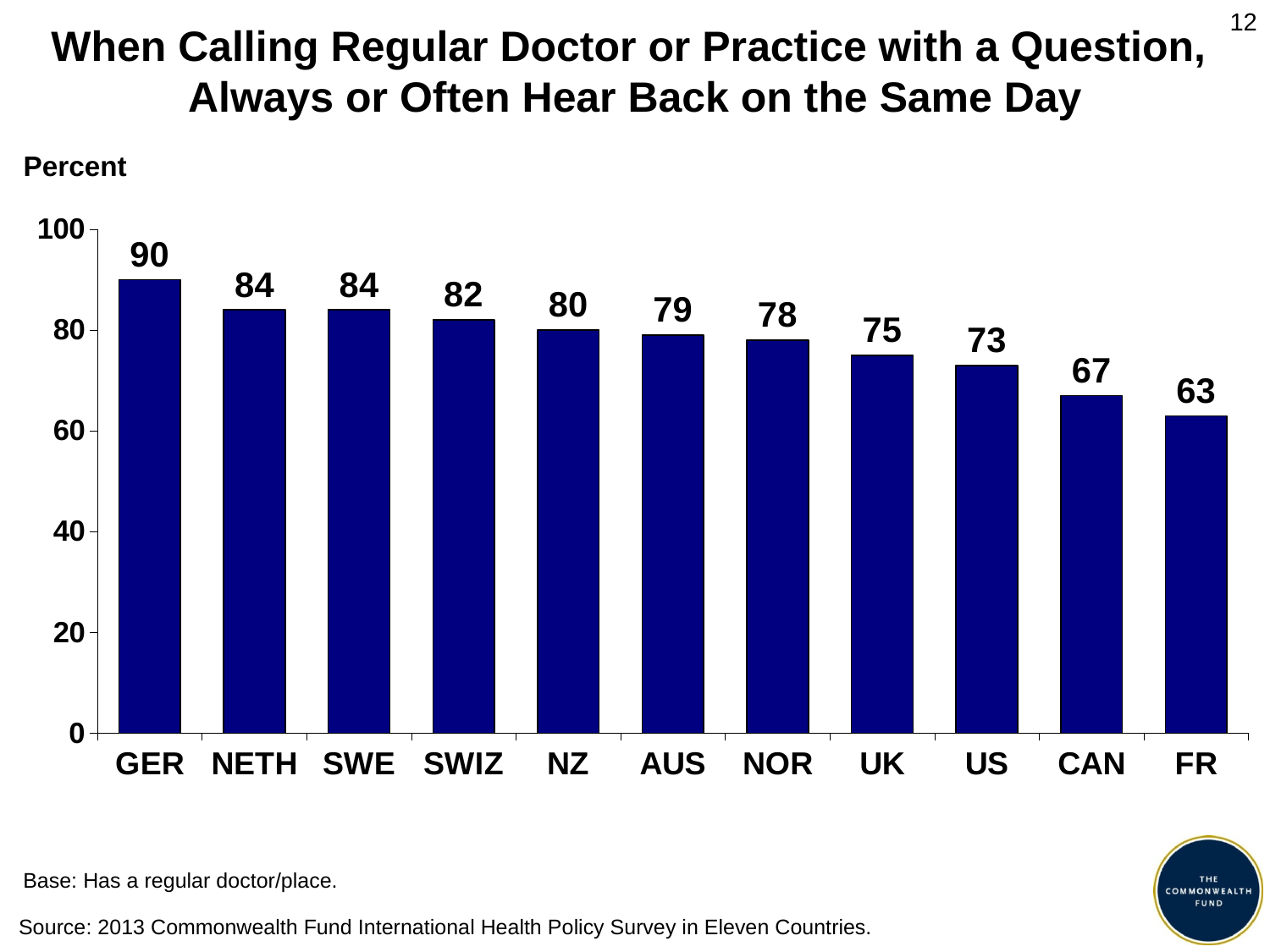
Is the value for SWIZ greater or less than 80? greater What is the value for UK? 75 How many countries are shown on the chart? 11 What is the value for CAN? 67 What is the difference between the values for NETH and US? 11 Do the values rise or fall from left to right along the x axis? fall Which country has the lowest value? FR Which country has the highest value? GER What is the difference between the values for GER and FR? 27 What kind of chart is shown on the slide? bar chart Which is larger, the value for NZ or the value for NOR? NZ What is the value for GER? 90